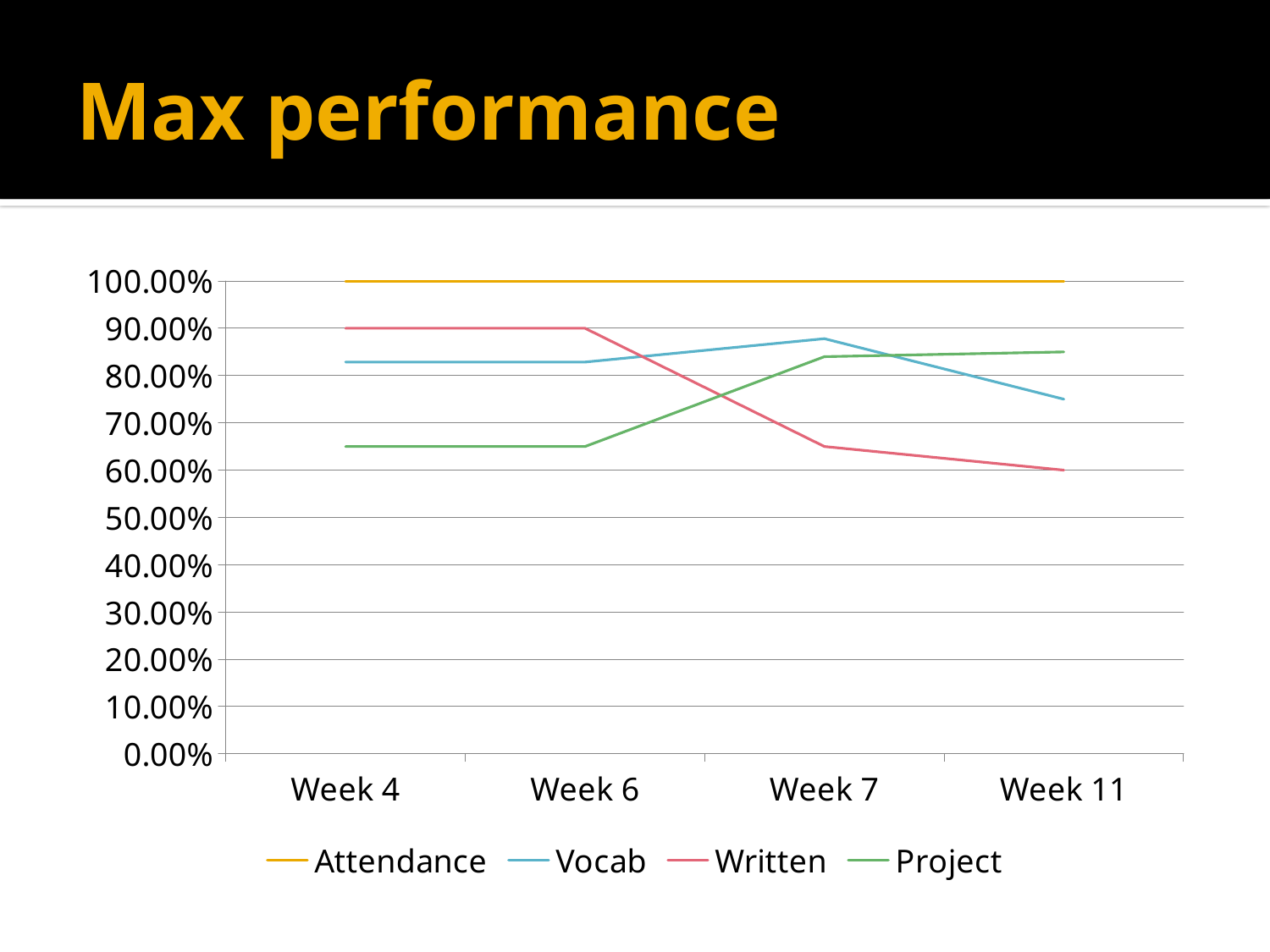
What is the value for Attendance at Week 11? 100.00% What is the value for Written at Week 11? 60.00% What kind of chart is shown on the slide? line chart What is the value for Written at Week 4? 90.00% Which series has the lowest value at Week 11? Written How many series does the legend list? 4 Does the Written series rise or fall from Week 6 to Week 11? fall Is the value for Vocab at Week 4 greater or less than 80.00%? greater What is the title of the chart? Max performance Which series has the highest value at Week 6? Attendance Is the value for Project at Week 6 greater or less than 70.00%? less How many weeks are shown on the x axis? 4